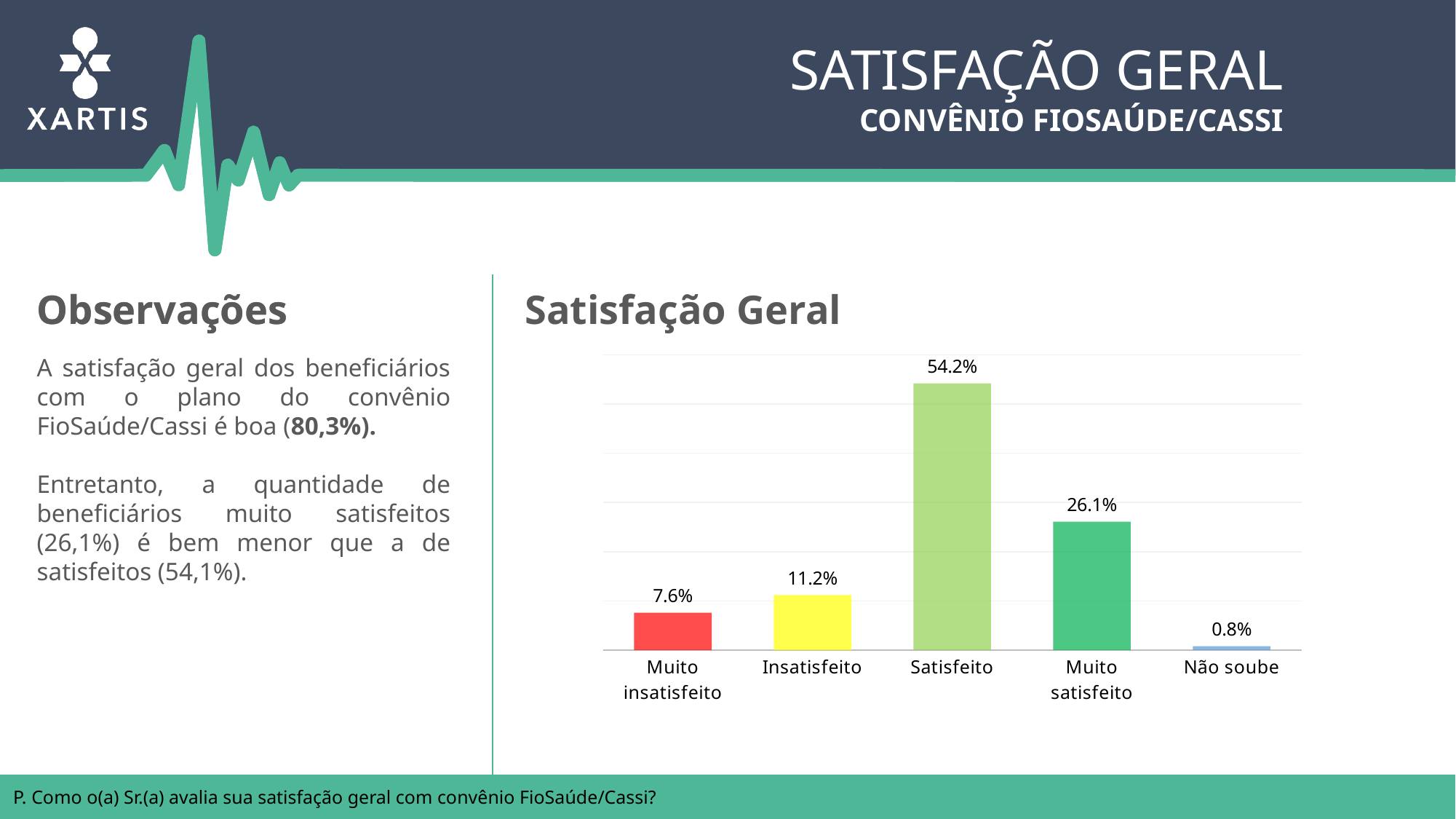
Which category has the highest value? Satisfeito What is the value for Satisfeito? 54.2% What colour is the bar for Muito insatisfeito? Red Which category has the lowest value? Não soube What is the title of the chart? Satisfação Geral What is the difference between the values for Satisfeito and Muito satisfeito? 28.1% What is the value for Não soube? 0.8% What kind of chart is shown on the slide? Bar chart What is the value for Insatisfeito? 11.2% How many categories are shown on the x axis? 5 What is the value for Muito insatisfeito? 7.6% Which is larger, the value for Insatisfeito or the value for Muito insatisfeito? Insatisfeito